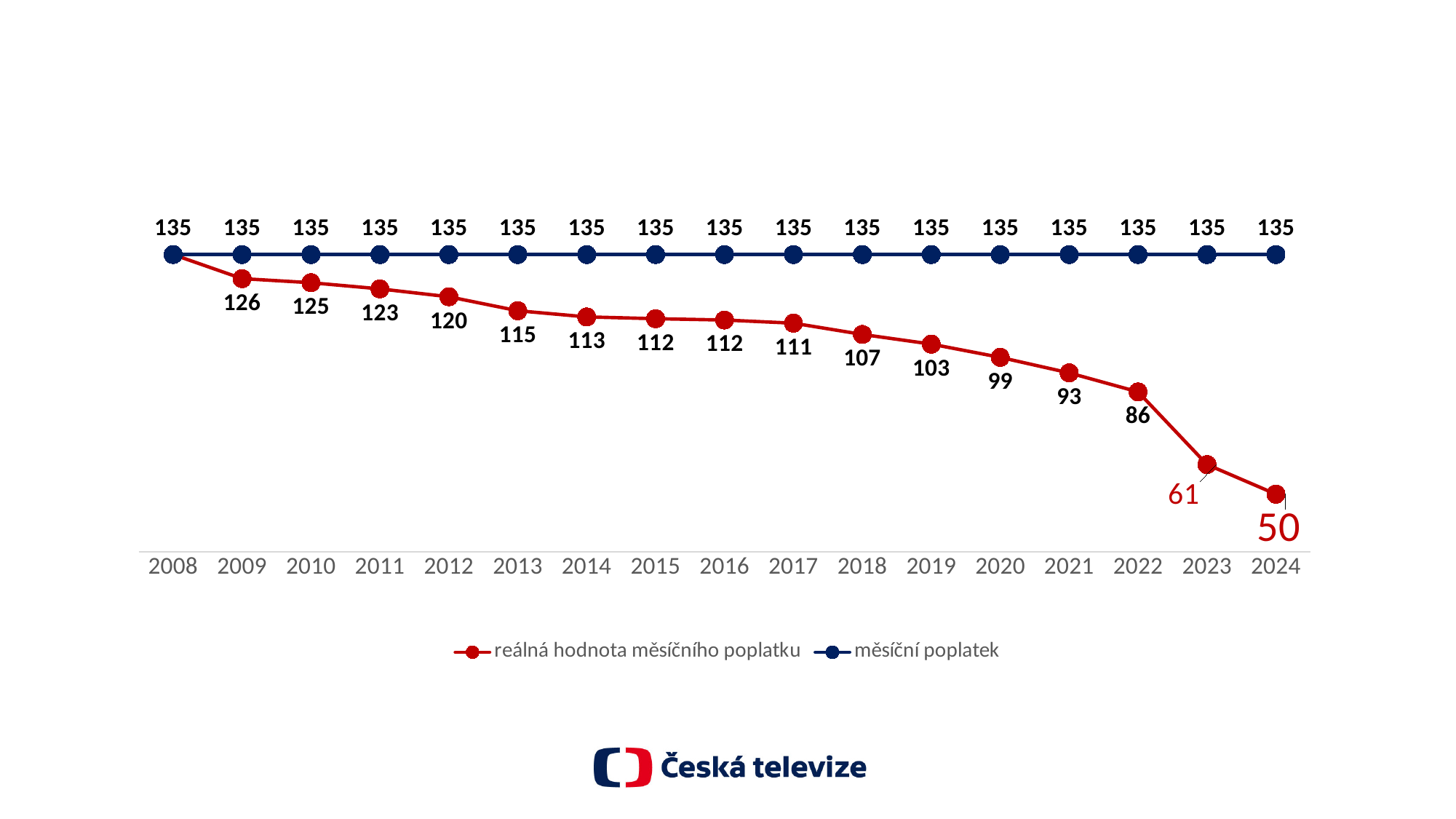
In which year is 'reálná hodnota měsíčního poplatku' lowest? 2024 What is the value of 'reálná hodnota měsíčního poplatku' in 2024? 50 What is the value of 'reálná hodnota měsíčního poplatku' in 2013? 115 What is the value of 'reálná hodnota měsíčního poplatku' in 2020? 99 How many years are shown on the x axis? 17 Which is larger in 2019: 'reálná hodnota měsíčního poplatku' or 'měsíční poplatek'? měsíční poplatek What kind of chart is shown on the slide? line chart What is the value of 'měsíční poplatek' in 2016? 135 What is the difference between 'měsíční poplatek' and 'reálná hodnota měsíčního poplatku' in 2024? 85 What is the difference between the 'reálná hodnota měsíčního poplatku' values for 2022 and 2023? 25 Does 'reálná hodnota měsíčního poplatku' rise or fall from 2008 to 2024? fall How many series does the legend list? 2